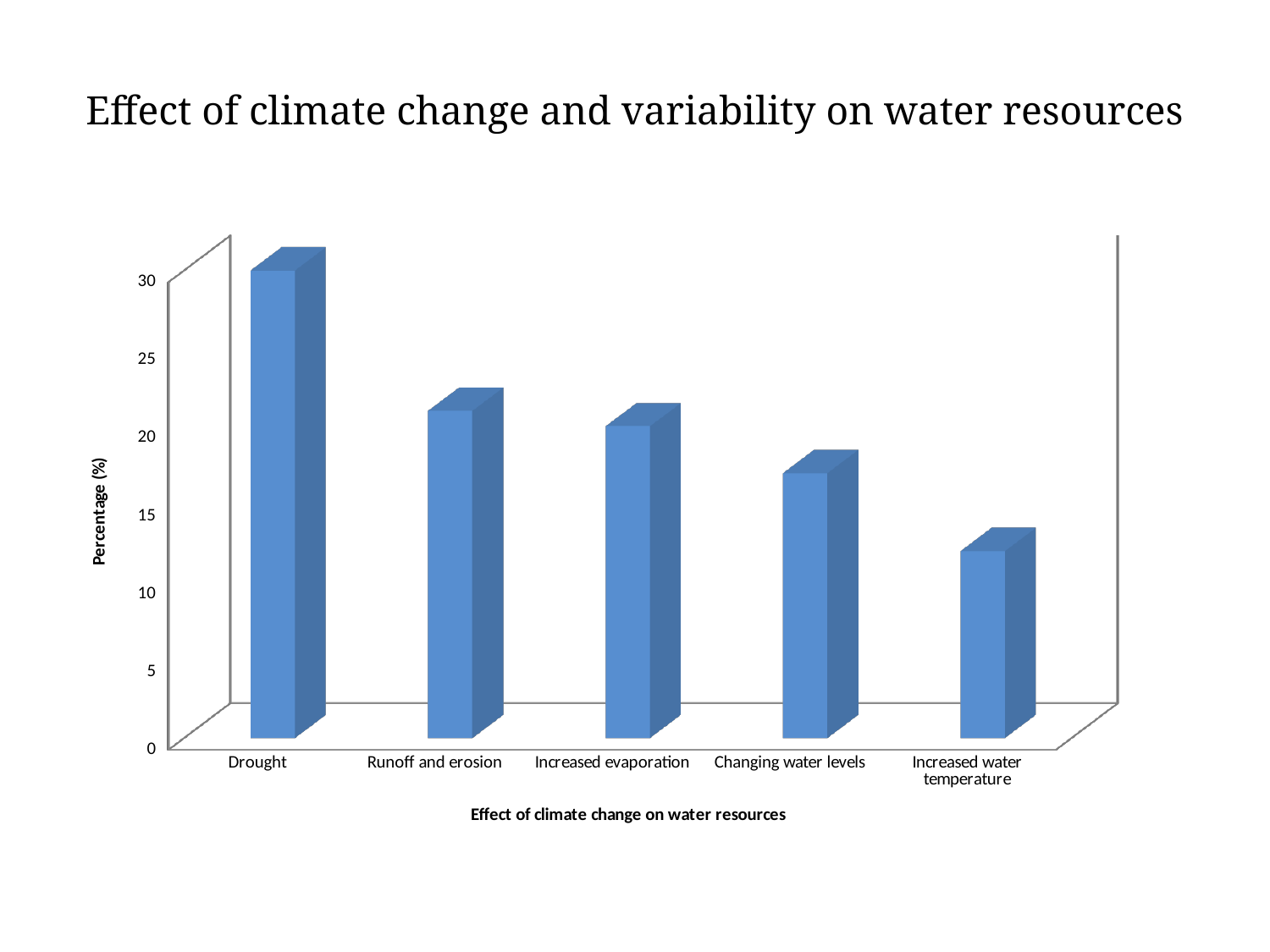
Do the values rise or fall moving from left to right along the x axis? fall Which category has the lowest value in the chart? Increased water temperature What kind of chart is shown on the slide? bar chart How many categories are shown on the x axis of the chart? 5 Which is larger, the value for Runoff and erosion or the value for Increased water temperature? Runoff and erosion Is the value for Increased evaporation greater or less than 25? less Which category has the highest value in the chart? Drought Is the value for Drought greater or less than 25? greater Is the value for Increased water temperature greater or less than 15? less What is the title of the vertical axis of the chart? Percentage (%) Which is larger, the value for Drought or the value for Changing water levels? Drought